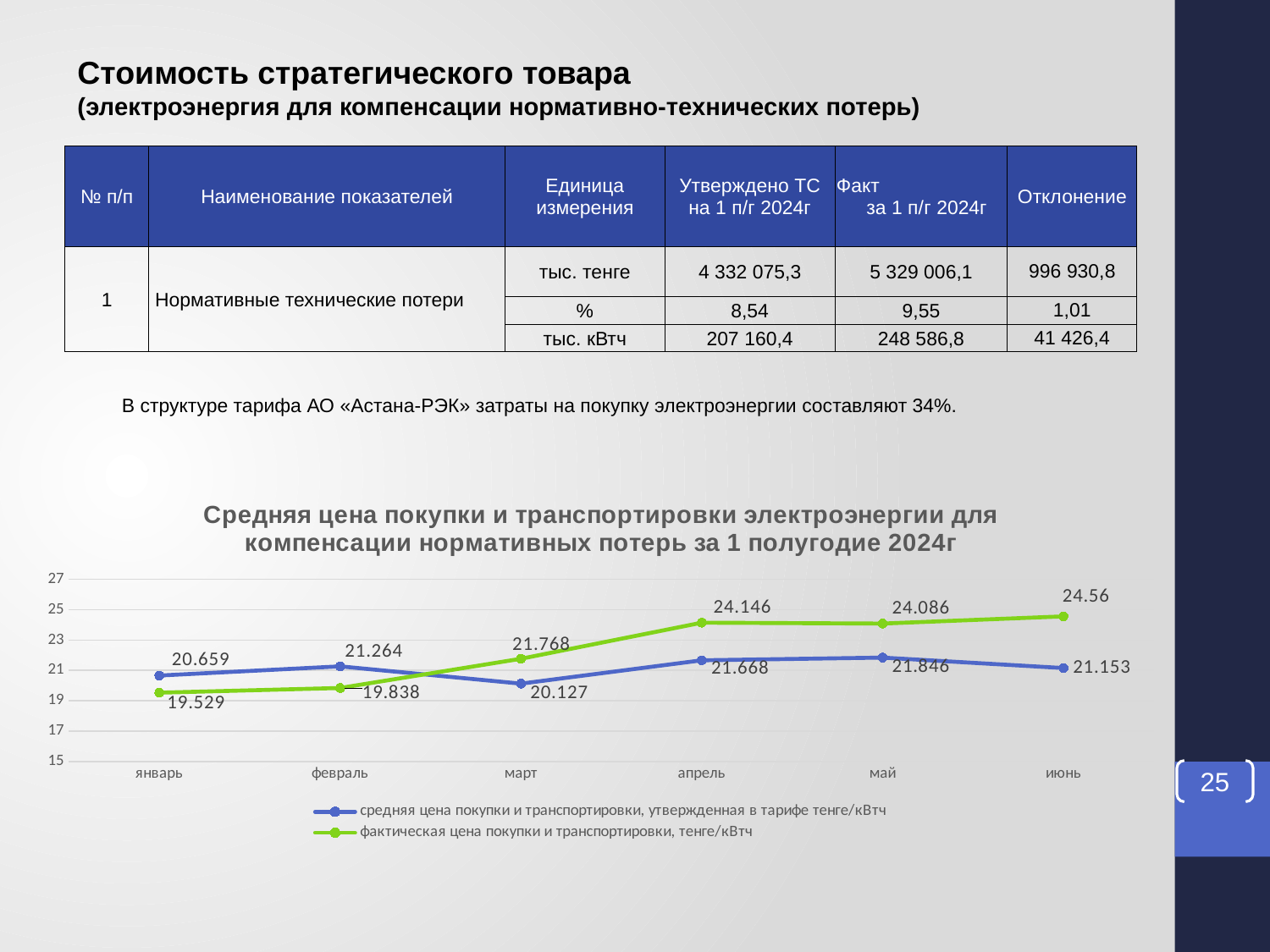
How many months are plotted along the x axis of the chart? 6 What type of chart is shown on the slide? line chart How many series does the chart legend list? 2 What is the tariff-approved price (утвержденная в тарифе) in февраль? 21.264 In which month is the actual price (фактическая цена) the lowest? январь What is the actual price (фактическая цена) in январь? 19.529 In which month is the actual price (фактическая цена) the highest? июнь Does the actual price (фактическая цена) generally rise or fall from январь to июнь? rise What is the actual purchase and transportation price (фактическая цена) in июнь? 24.56 Which is larger in апрель: the actual price or the tariff-approved price? the actual price (24.146) In which month is the tariff-approved price (утвержденная в тарифе) the lowest? март What is the difference between the actual price and the tariff-approved price in май? 2.240